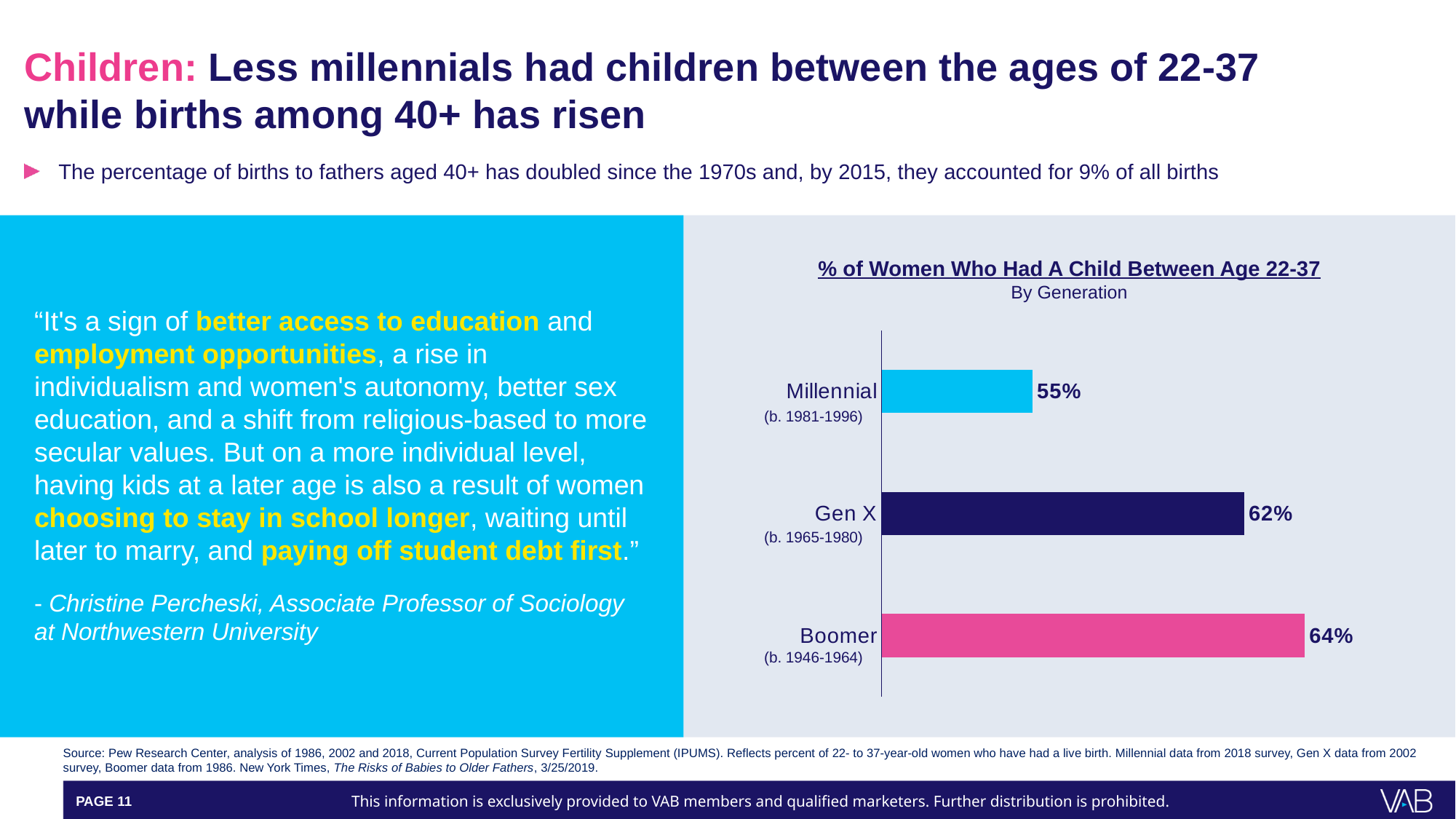
What type of chart is used to show the percentage of women who had a child between age 22-37? Bar chart Which generation has the highest percentage of women who had a child between age 22-37? Boomer What percentage of Millennial women had a child between age 22-37? 55% What is the difference in percentage points between Gen X and Millennial women who had a child between age 22-37? 7 percentage points What is the difference in percentage points between Boomer and Millennial women who had a child between age 22-37? 9 percentage points What is the title of the chart? % of Women Who Had A Child Between Age 22-37 Which generation has the lowest percentage of women who had a child between age 22-37? Millennial What percentage of Gen X women had a child between age 22-37? 62% Which is larger: the percentage for Gen X or for Millennial? Gen X How many generations are shown in the chart? 3 What birth years are given for the Gen X generation in the chart? b. 1965-1980 What percentage of Boomer women had a child between age 22-37? 64%